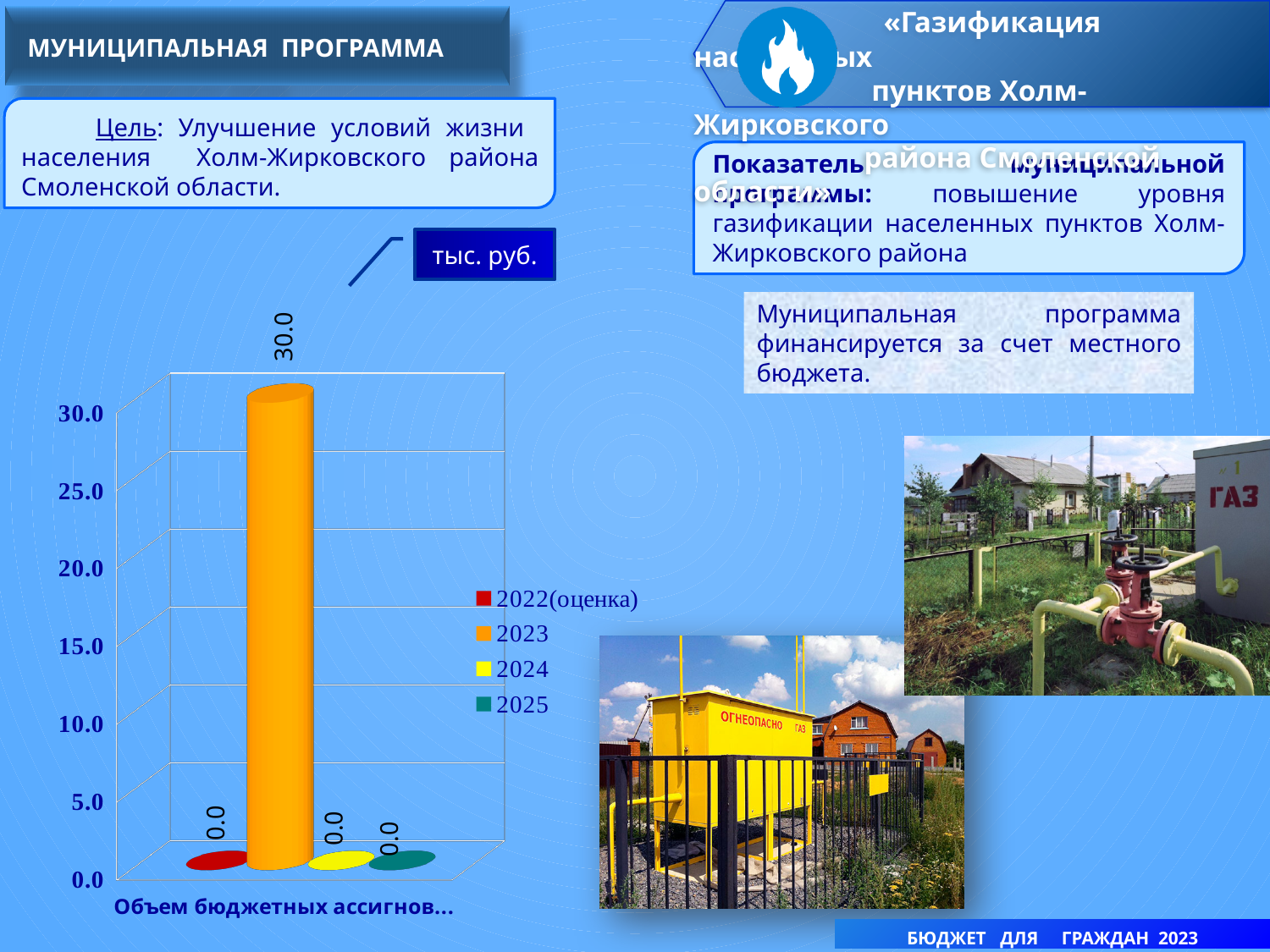
What unit of measurement is indicated for the chart values? тыс. руб. Is the value for 2023 greater or less than 25.0? greater What colour is the bar for 2023 in the chart? orange What is the value for 2025 on the chart? 0.0 What is the value for 2023 on the chart? 30.0 What is the value for 2024 on the chart? 0.0 Which series has the highest value on the chart? 2023 What kind of chart is shown on the slide? bar chart Which is larger, the value for 2023 or the value for 2025? 2023 How many series does the legend list? 4 What is the value for 2022(оценка) on the chart? 0.0 What is the difference between the values for 2023 and 2024? 30.0